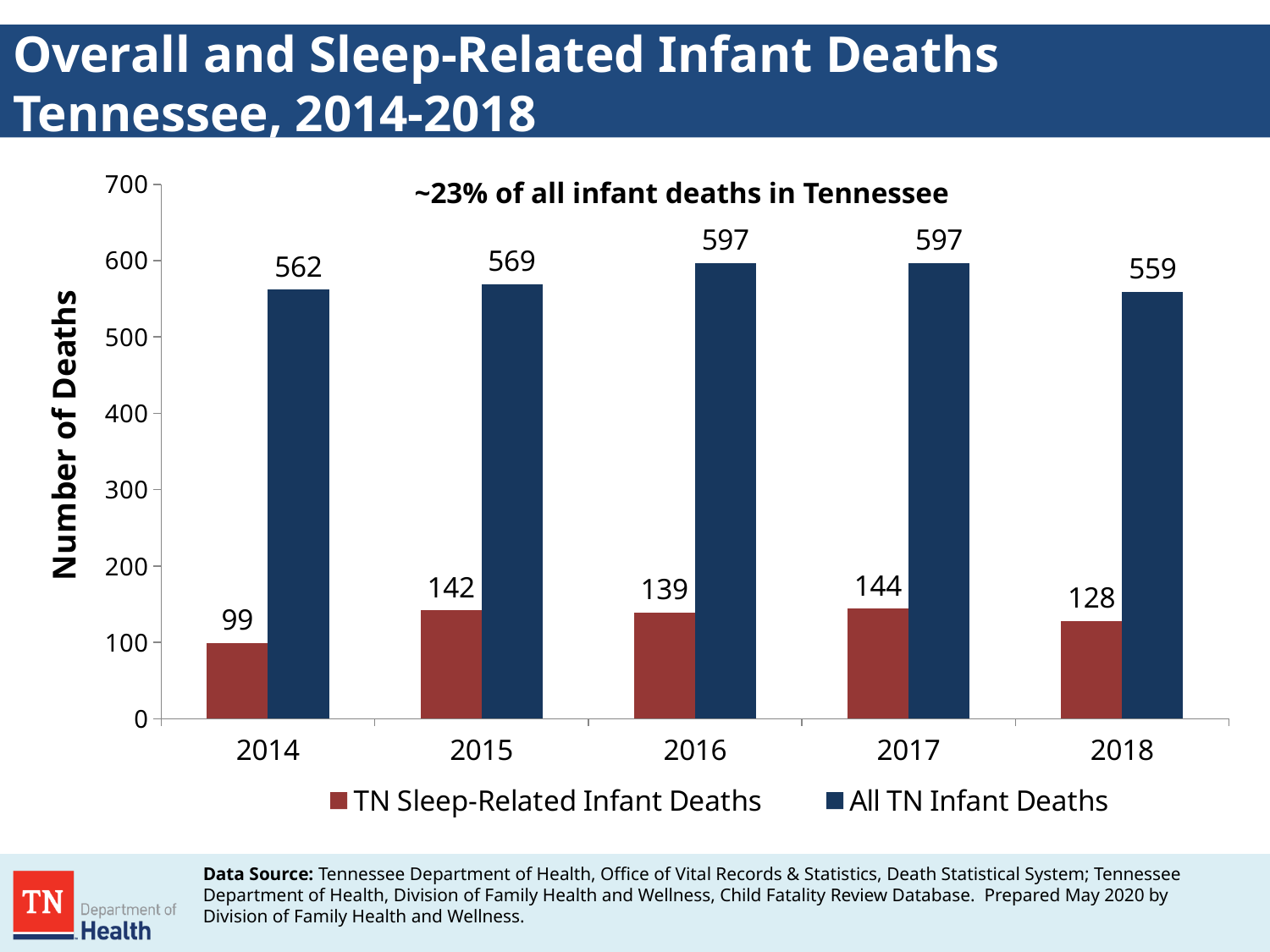
In which year were All TN Infant Deaths lowest? 2018 How many years are shown on the x axis? 5 What is the label on the y axis? Number of Deaths What is the value for All TN Infant Deaths in 2016? 597 In which year were TN Sleep-Related Infant Deaths lowest? 2014 What is the value for TN Sleep-Related Infant Deaths in 2018? 128 In which year were TN Sleep-Related Infant Deaths highest? 2017 How many series does the legend list? 2 Which is larger: TN Sleep-Related Infant Deaths in 2015 or in 2016? 2015 What is the difference between All TN Infant Deaths and TN Sleep-Related Infant Deaths in 2015? 427 What is the value for TN Sleep-Related Infant Deaths in 2014? 99 What kind of chart is shown on the slide? Bar chart